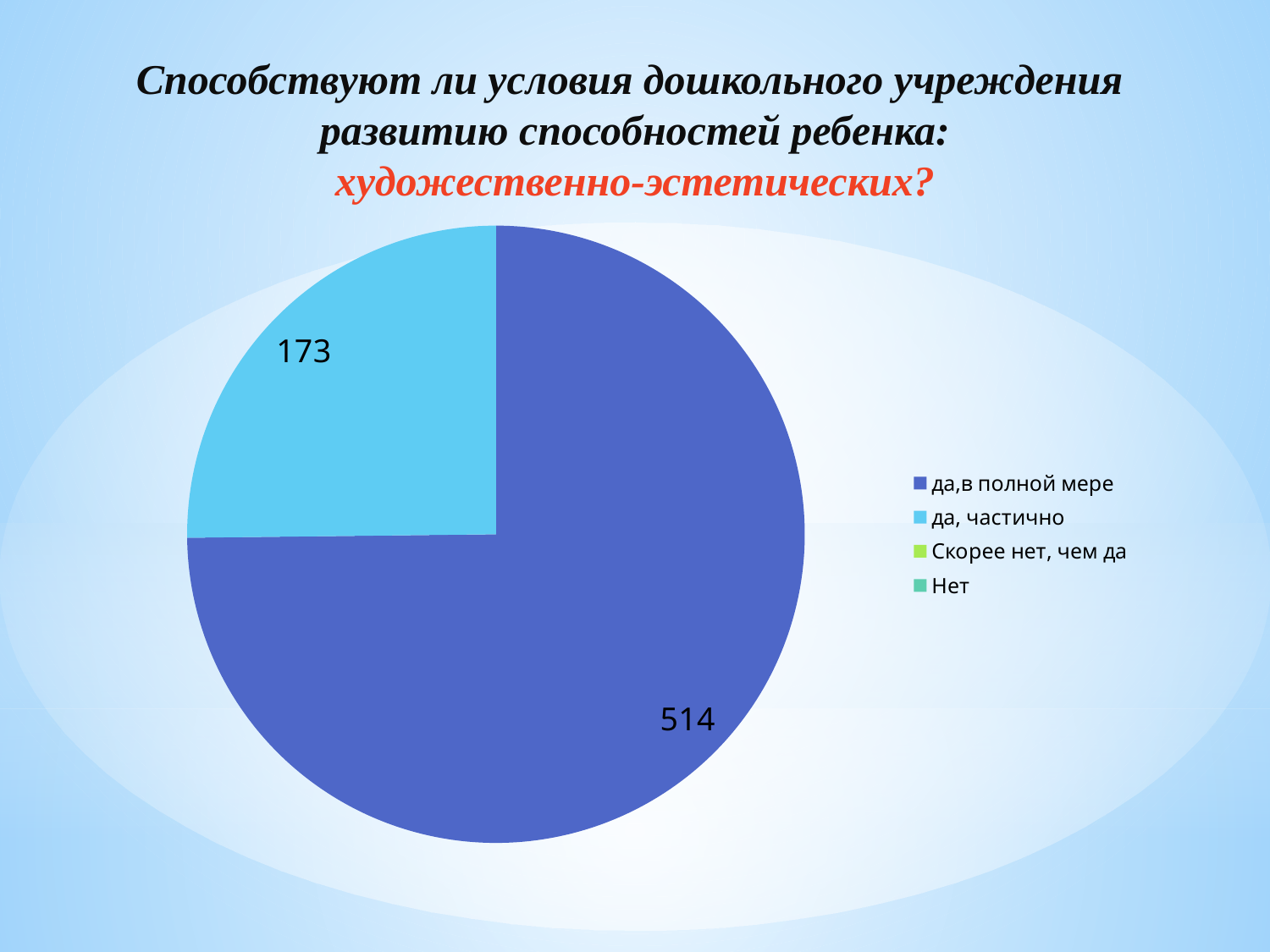
What colour is the slice for "да,в полной мере"? Dark blue Is the value for "да, частично" greater or less than 200? less Which legend entry is shown in light blue? да, частично How many entries does the legend list? 4 What kind of chart is shown on the slide? Pie chart What is the difference between the values for "да,в полной мере" and "да, частично"? 341 What value is shown for the slice "да, частично"? 173 Which is larger: the value for "да, частично" or the value for "да,в полной мере"? да,в полной мере Which category has the largest slice of the pie? да,в полной мере What value is shown for the slice "да,в полной мере"? 514 How many slices of the pie have a data label printed on them? 2